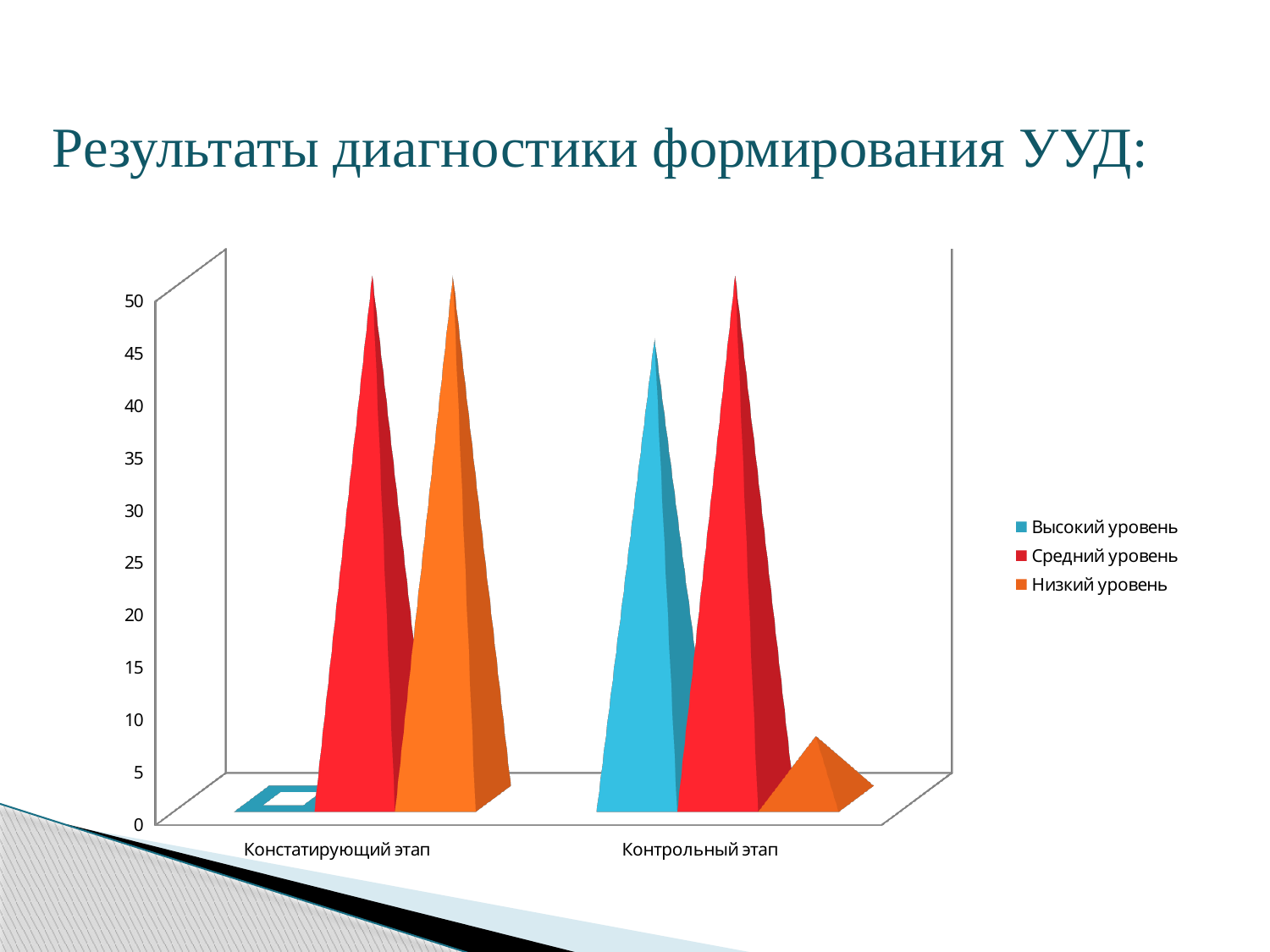
Is the value for Низкий уровень at Контрольный этап greater or less than 10? less Is the value for Высокий уровень at Констатирующий этап greater or less than 5? less Does the value for Низкий уровень rise or fall from Констатирующий этап to Контрольный этап? fall Is the value for Средний уровень at Констатирующий этап greater or less than 40? greater How many categories are shown on the x axis of the chart? 2 Which series is shown in orange in the chart? Низкий уровень What is the title of the slide containing the chart? Результаты диагностики формирования УУД: How many series does the chart legend list? 3 Which series has the lowest value at Констатирующий этап? Высокий уровень What kind of chart is shown on the slide? bar chart Which series has the lowest value at Контрольный этап? Низкий уровень